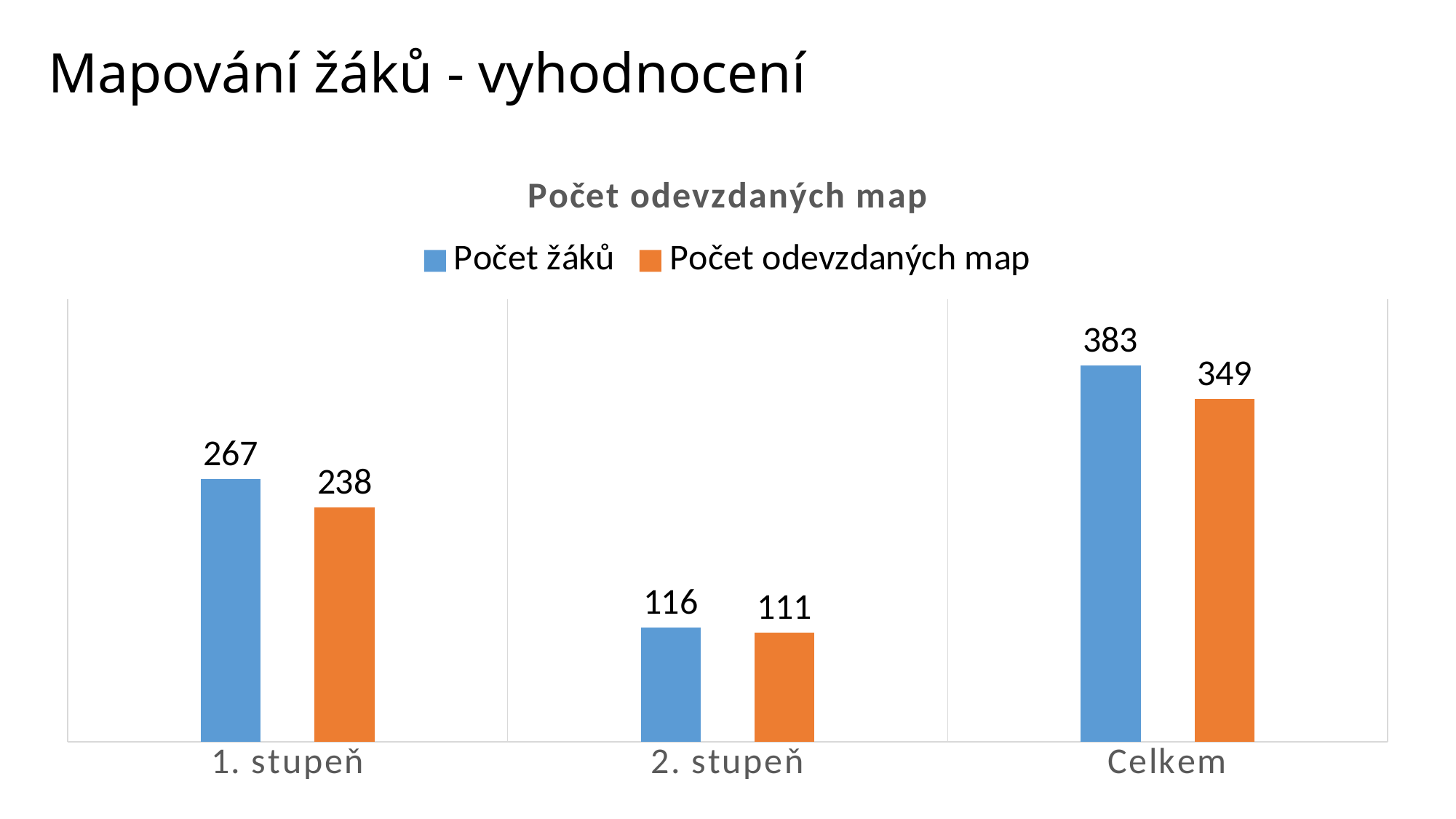
How many categories are shown on the x axis? 3 Which is larger for 2. stupeň: Počet žáků or Počet odevzdaných map? Počet žáků What is the title of the chart? Počet odevzdaných map What kind of chart is shown on the slide? Bar chart Which category has the highest value for Počet žáků? Celkem Which category has the lowest value for Počet odevzdaných map? 2. stupeň What is the value of Počet odevzdaných map for 2. stupeň? 111 What is the difference between Počet žáků and Počet odevzdaných map for 1. stupeň? 29 How many series does the legend list? 2 What is the value of Počet žáků for 1. stupeň? 267 What is the value of Počet odevzdaných map for Celkem? 349 What is the difference between Počet žáků and Počet odevzdaných map for Celkem? 34